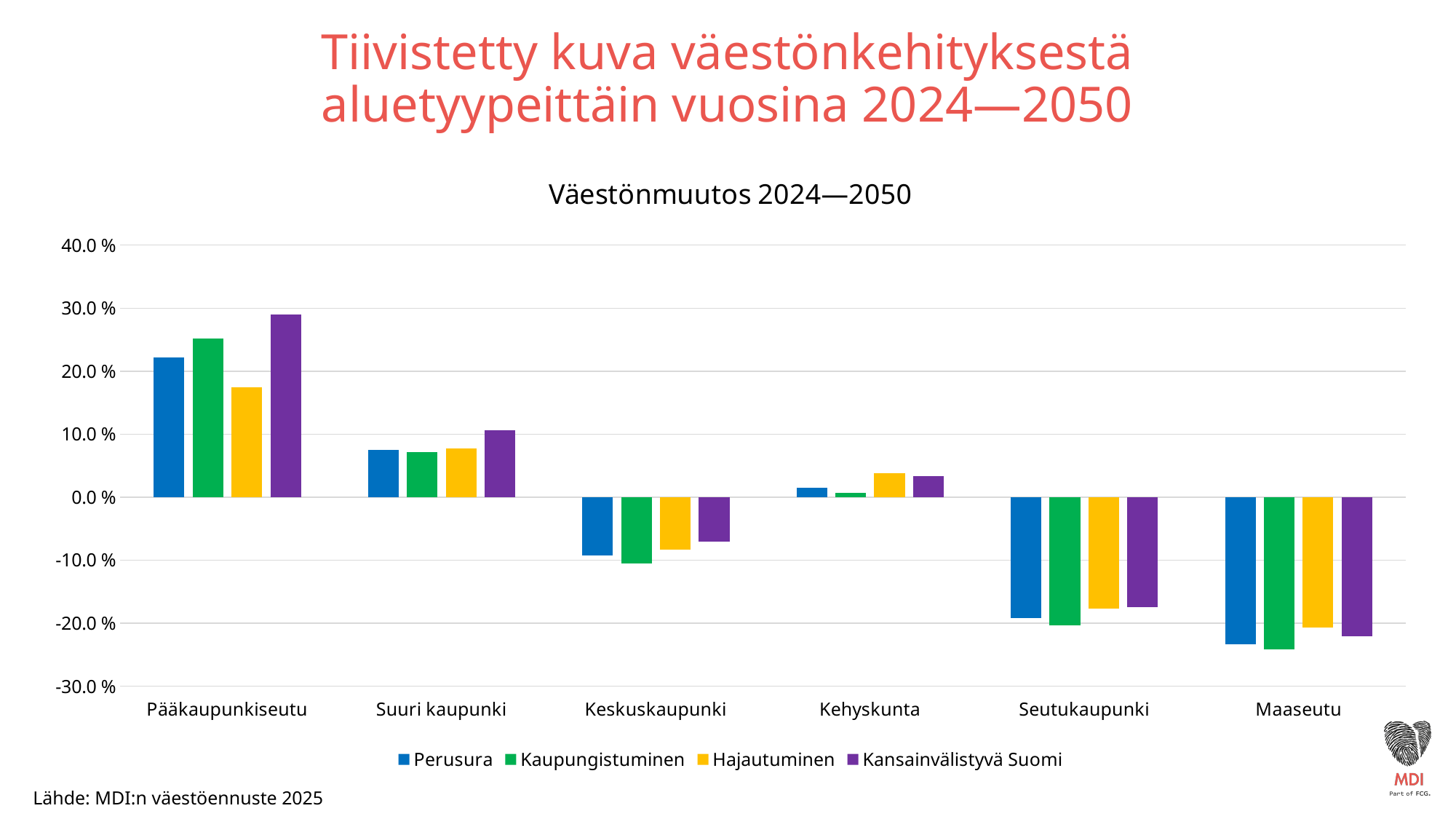
Which series has the highest value for Pääkaupunkiseutu? Kansainvälistyvä Suomi What kind of chart is shown on the slide? Bar chart What is the title of the chart? Väestönmuutos 2024—2050 For Pääkaupunkiseutu, which is larger: the Kaupungistuminen value or the Hajautuminen value? Kaupungistuminen For Suuri kaupunki, which is larger: the Kansainvälistyvä Suomi value or the Perusura value? Kansainvälistyvä Suomi Which category has the lowest value for the Kaupungistuminen series? Maaseutu Is the Hajautuminen value for Maaseutu greater or less than -10.0 %? less Is the Perusura value for Seutukaupunki greater or less than -10.0 %? less Is the Kansainvälistyvä Suomi value for Pääkaupunkiseutu greater or less than 20.0 %? greater Which category has the highest value for the Kansainvälistyvä Suomi series? Pääkaupunkiseutu How many series does the legend list? 4 How many area-type categories are shown on the x axis? 6